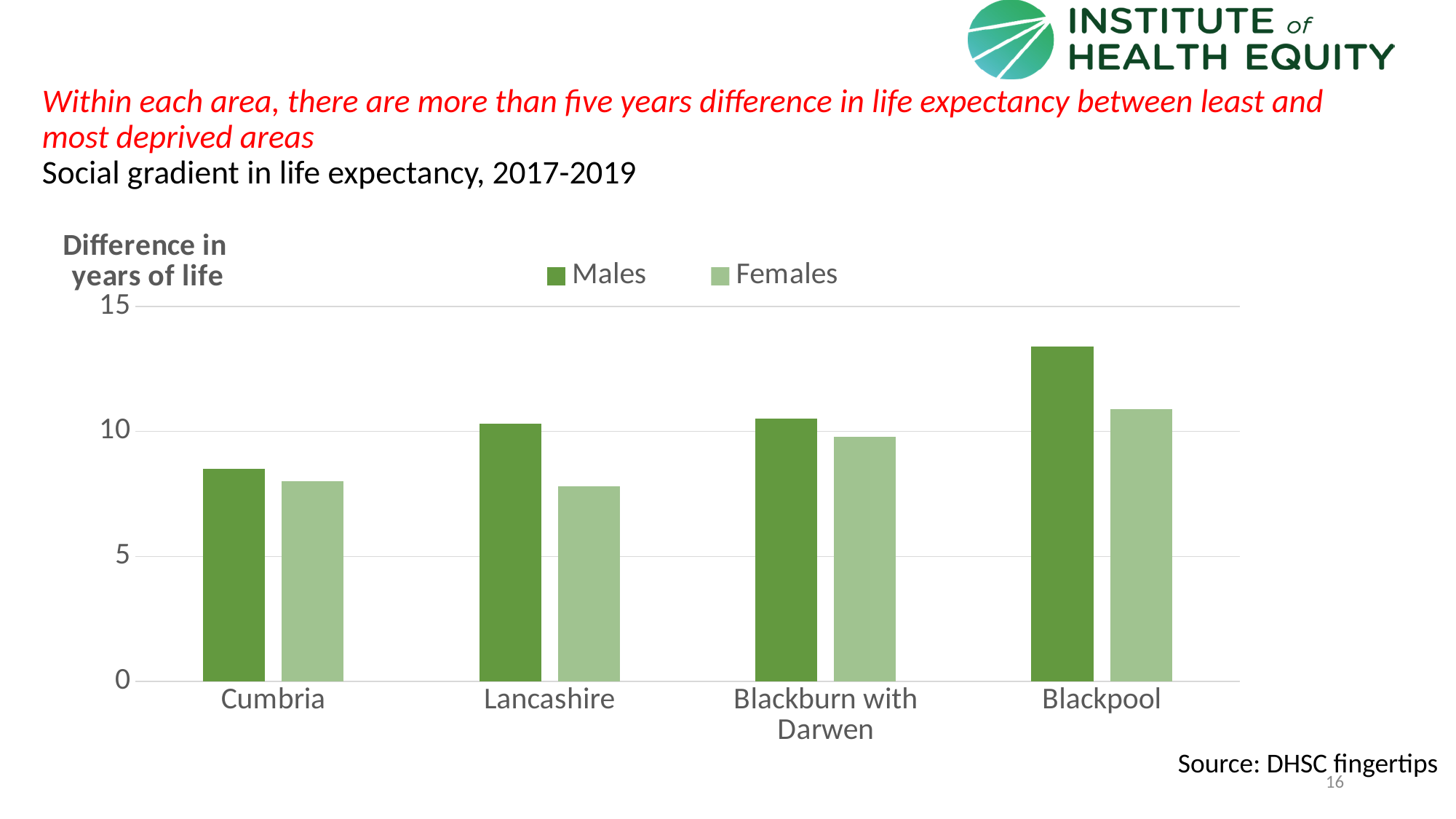
Is the value for Males in Blackpool greater or less than 10? greater Which is larger: the Males value for Blackpool or the Males value for Blackburn with Darwen? Blackpool What kind of chart is shown on the slide? bar chart Is the value for Females in Lancashire greater or less than 10? less How many series does the legend list? 2 Which area has the lowest value for Males? Cumbria Which area has the highest value for Males? Blackpool Which area has the highest value for Females? Blackpool Do the Males values rise or fall from Cumbria to Blackpool along the x axis? rise How many areas are shown on the x axis? 4 Is the value for Males in Cumbria greater or less than 10? less In Lancashire, which is larger: the Males value or the Females value? Males